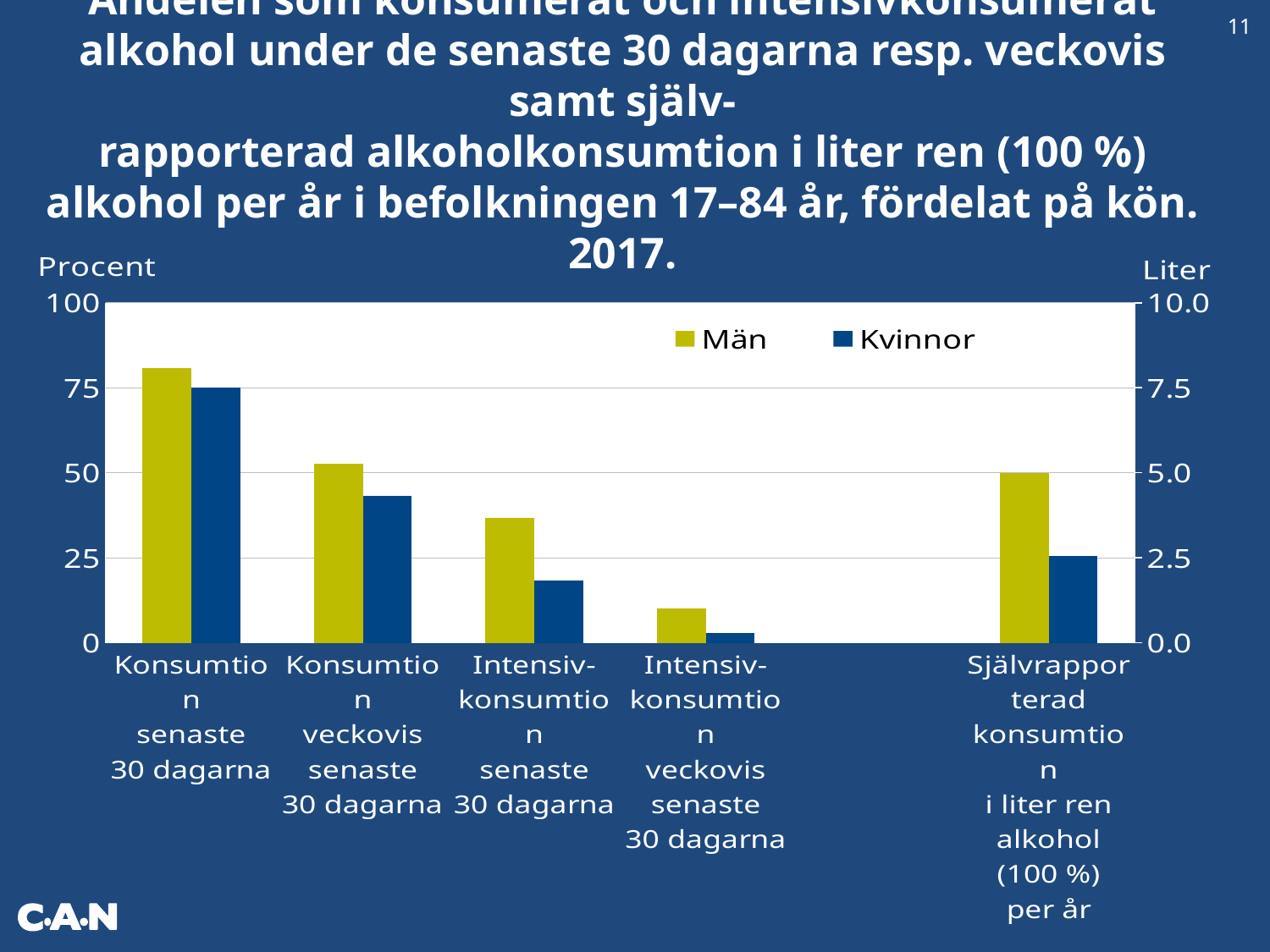
For Intensiv-konsumtion senaste 30 dagarna, which series has the larger value, Män or Kvinnor? Män How many series does the legend list? 2 Which two series are listed in the legend? Män and Kvinnor Is the value for Män in Konsumtion senaste 30 dagarna greater or less than 75? greater What kind of chart is shown on the slide? bar chart Is the value for Kvinnor in Konsumtion veckovis senaste 30 dagarna greater or less than 50? less Is the value for Män in Intensiv-konsumtion senaste 30 dagarna greater or less than 25? greater Across the first four categories from left to right, do the values for Män rise or fall? fall Which category has the highest value for Män? Konsumtion senaste 30 dagarna Which category has the lowest value for Kvinnor? Intensiv-konsumtion veckovis senaste 30 dagarna How many categories are shown on the x axis? 5